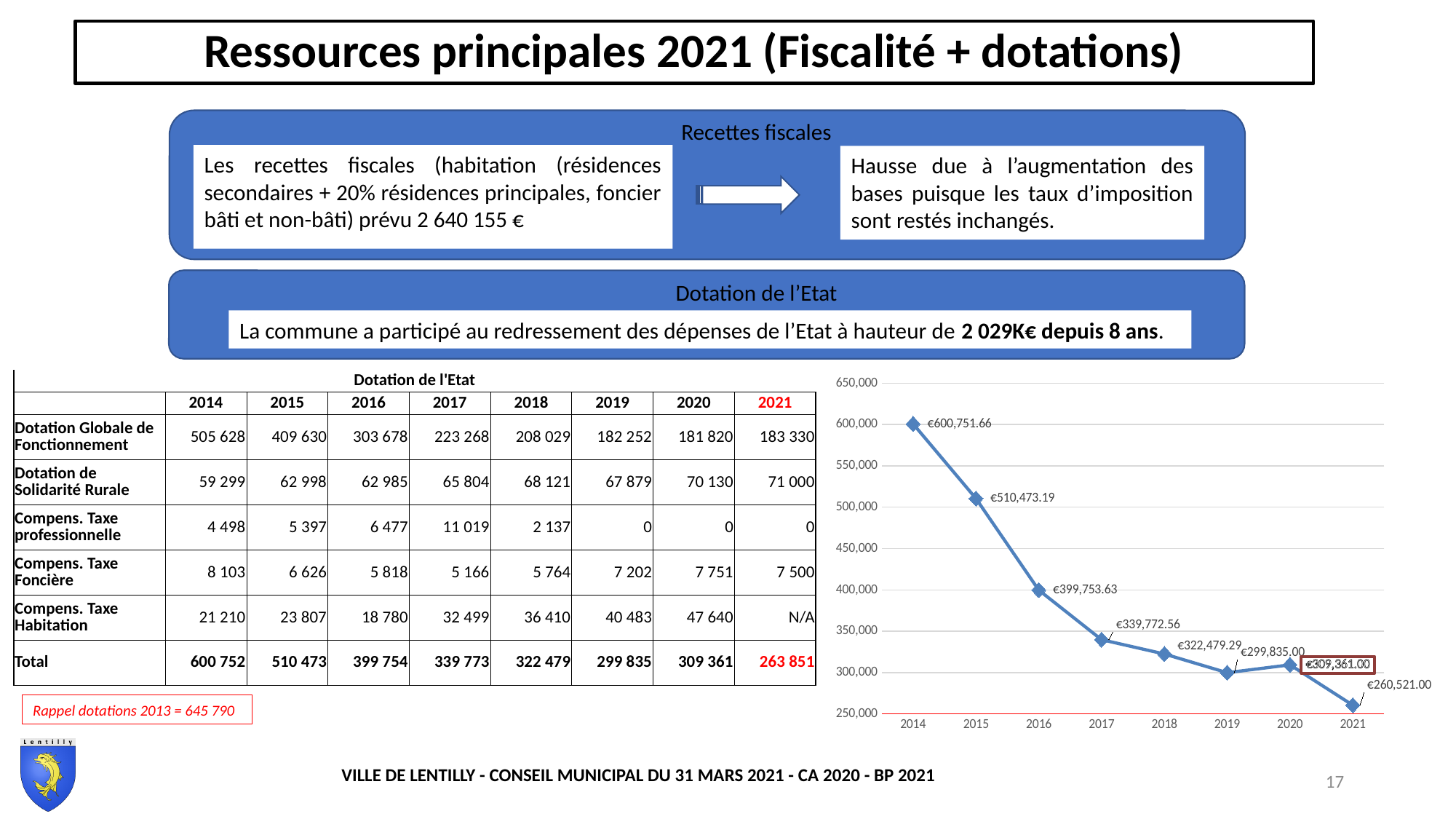
In the line chart, which year has the lowest value? 2021 In the line chart, what is the value for 2014? €600,751.66 What type of chart is shown on the right side of the slide? line chart In the line chart, what is the difference between the 2020 value and the 2019 value? €9,526.00 In the line chart, what is the value for 2019? €299,835.00 How many data points are plotted in the line chart? 8 In the line chart, what is the value for 2017? €339,772.56 In the line chart, which year has the highest value? 2014 In the line chart, which year has the larger value, 2016 or 2018? 2016 In the line chart, what is the difference between the 2014 value and the 2021 value? €340,230.66 Do the values in the line chart generally rise or fall from 2014 to 2021? fall In the line chart, what is the value for 2021? €260,521.00